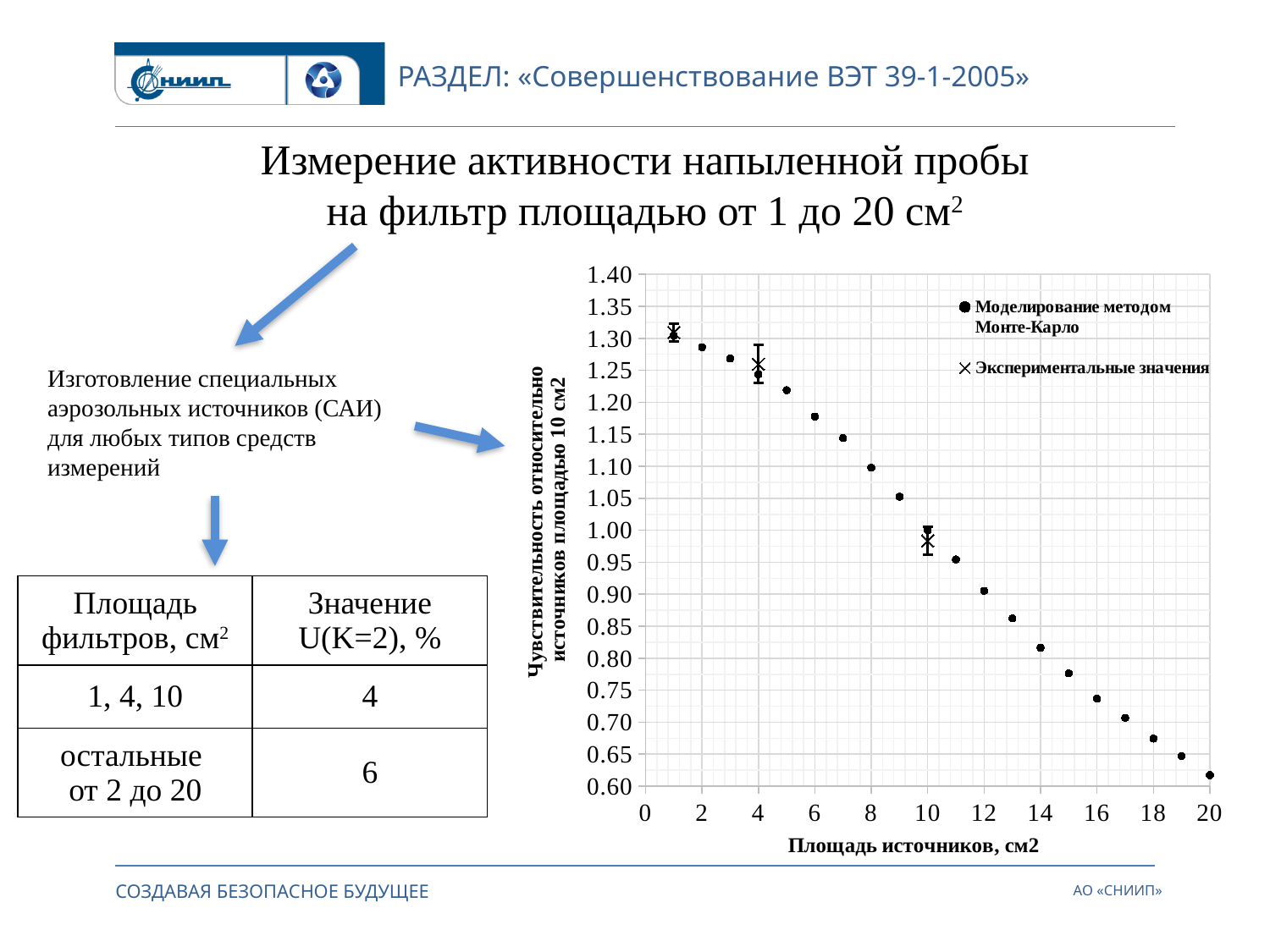
How many experimental value points (Экспериментальные значения) are plotted on the chart? 3 Do the Monte Carlo simulation values rise or fall as the source area increases along the x axis? fall At which source area is the Monte Carlo simulation value lowest? 20 How many Monte Carlo simulation points are plotted on the chart? 20 What is the label of the x axis of the chart? Площадь источников, см2 Which is larger: the Monte Carlo simulation value at 4 cm2 or at 10 cm2? 4 cm2 What are the two series named in the chart legend? Моделирование методом Монте-Карло; Экспериментальные значения Is the Monte Carlo simulation value at a source area of 20 cm2 greater or less than 0.65? less How many series does the chart legend list? 2 Is the Monte Carlo simulation value at a source area of 8 cm2 greater or less than 1.05? greater What kind of chart is shown on the slide? scatter chart At which source area is the Monte Carlo simulation value highest? 1